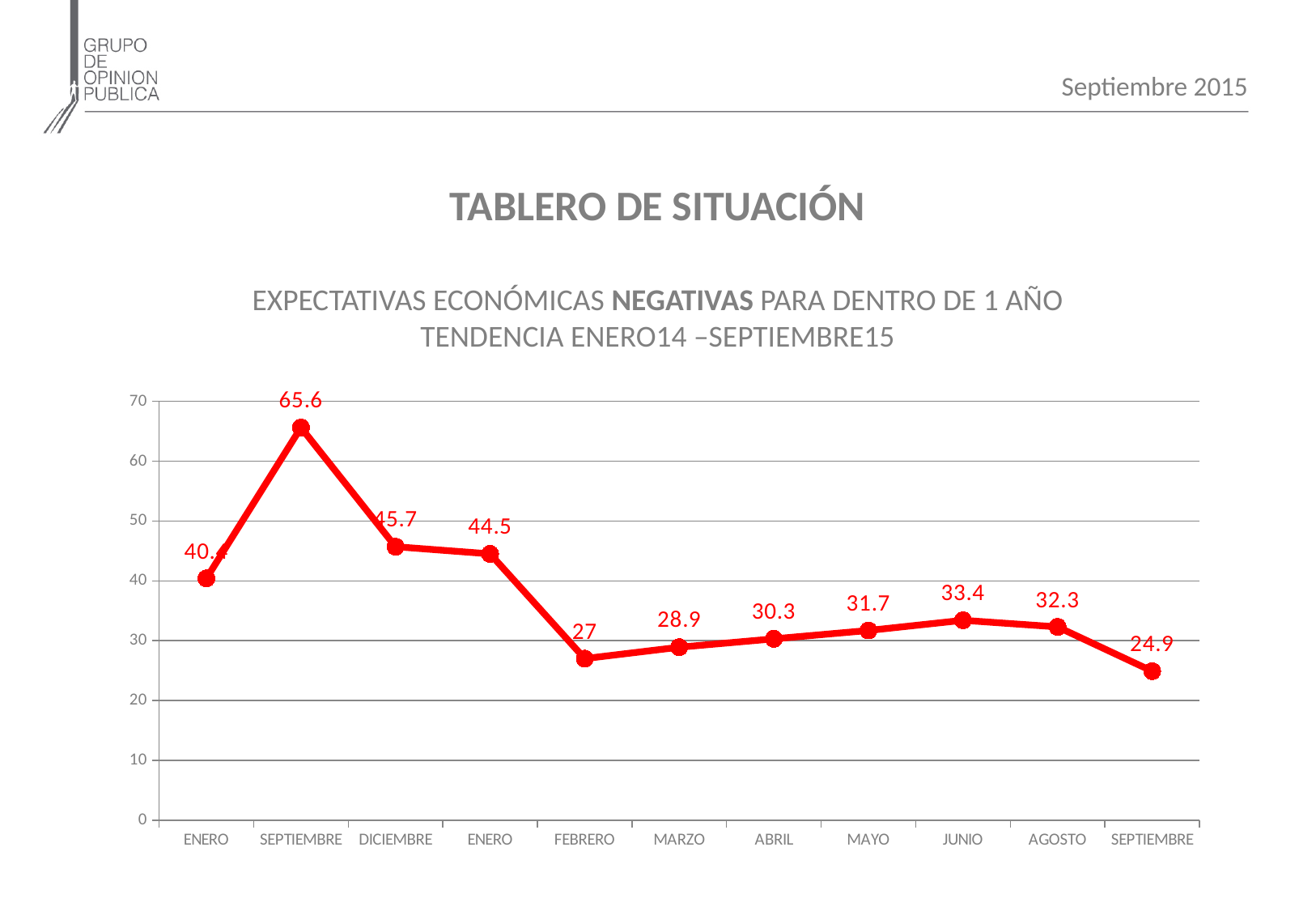
Do the values rise or fall from FEBRERO to JUNIO? rise What kind of chart is shown on the slide? line chart What is the value for FEBRERO? 27 What is the difference between the value for JUNIO and the value for FEBRERO? 6.4 Is the value for the first ENERO point greater or less than 50? less Which month has the lowest value on the chart? SEPTIEMBRE (the last point, 24.9) Which is larger, the value for MAYO or the value for AGOSTO? AGOSTO What is the value for DICIEMBRE? 45.7 What is the value for JUNIO? 33.4 What is the difference between the highest value (65.6) and the lowest value (24.9)? 40.7 Which month has the highest value on the chart? SEPTIEMBRE (the second point, 65.6) How many data points are plotted on the line? 11